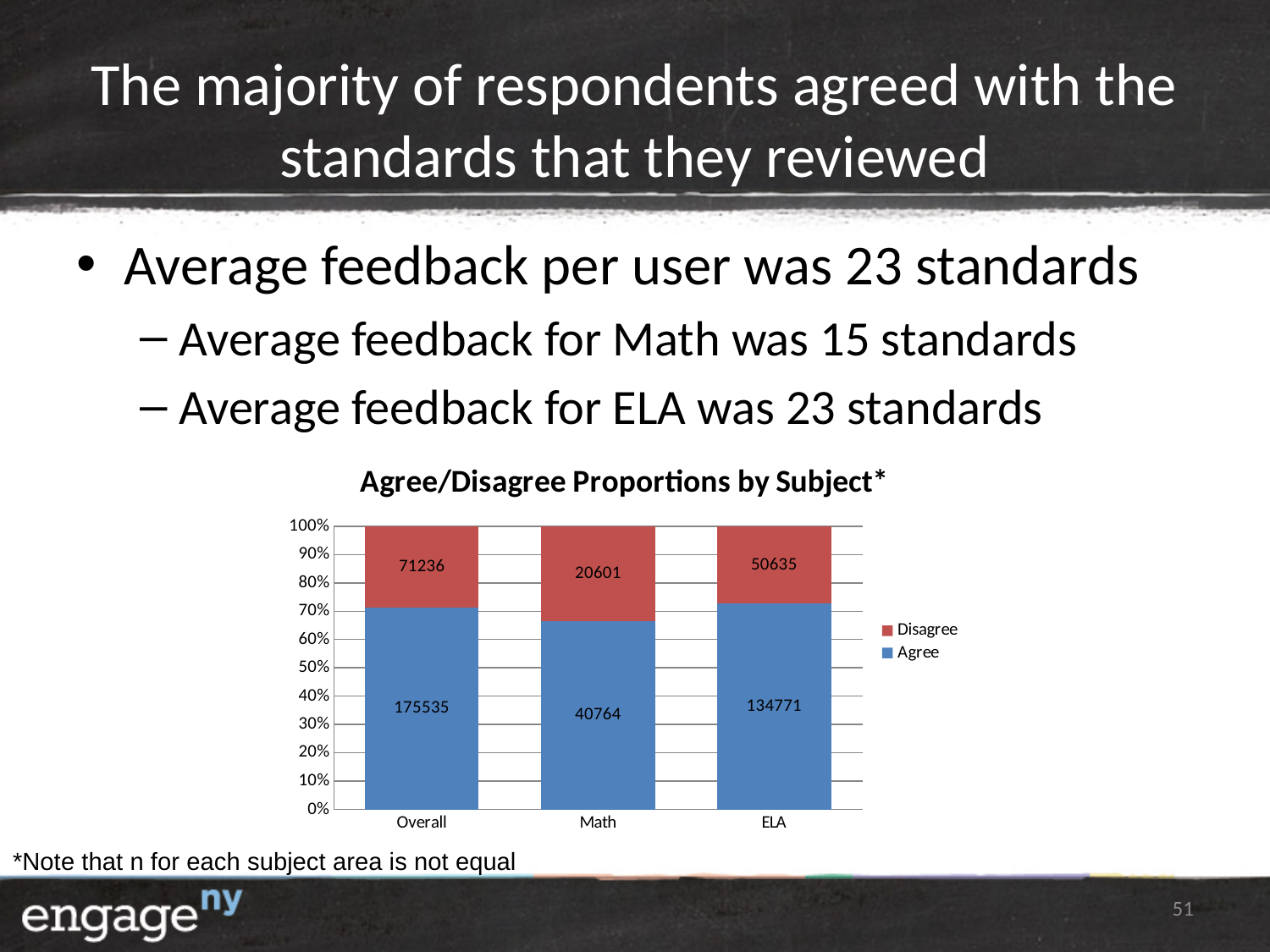
Is the Disagree value for ELA larger or smaller than the Disagree value for Math? larger What is the difference between the Agree and Disagree values for Math? 20163 What is the Disagree value for Math? 20601 Which category has the highest Disagree value? Overall How many series does the legend list? 2 What is the Agree value for Overall? 175535 How many categories are shown on the x axis? 3 What is the total of the Agree and Disagree values for ELA? 185406 What is the Agree value for ELA? 134771 Is the Agree share of the Math bar greater or less than 70%? less What is the title of the chart? Agree/Disagree Proportions by Subject* Which category has the lowest Agree value? Math